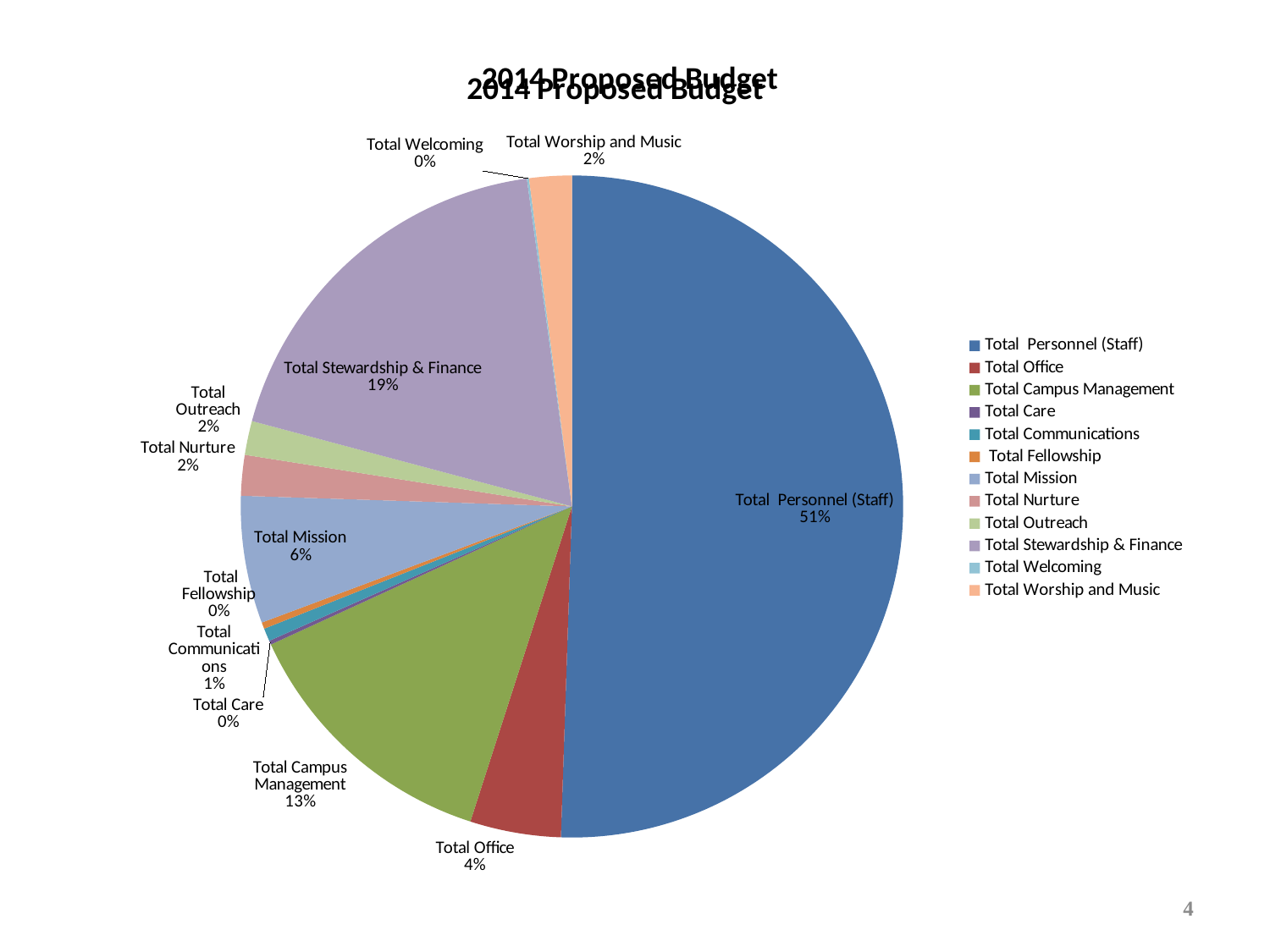
What share of the 2014 Proposed Budget is Total Communications? 1% Which category has the largest share of the 2014 Proposed Budget? Total Personnel (Staff) What share of the 2014 Proposed Budget is Total Campus Management? 13% What share of the 2014 Proposed Budget is Total Office? 4% What kind of chart is shown on the slide? pie chart What is the difference in percentage points between the Total Personnel (Staff) share and the Total Stewardship & Finance share? 32 percentage points How many categories does the legend of the pie chart list? 12 Which is larger, the share for Total Stewardship & Finance or the share for Total Campus Management? Total Stewardship & Finance What is the title of the chart? 2014 Proposed Budget